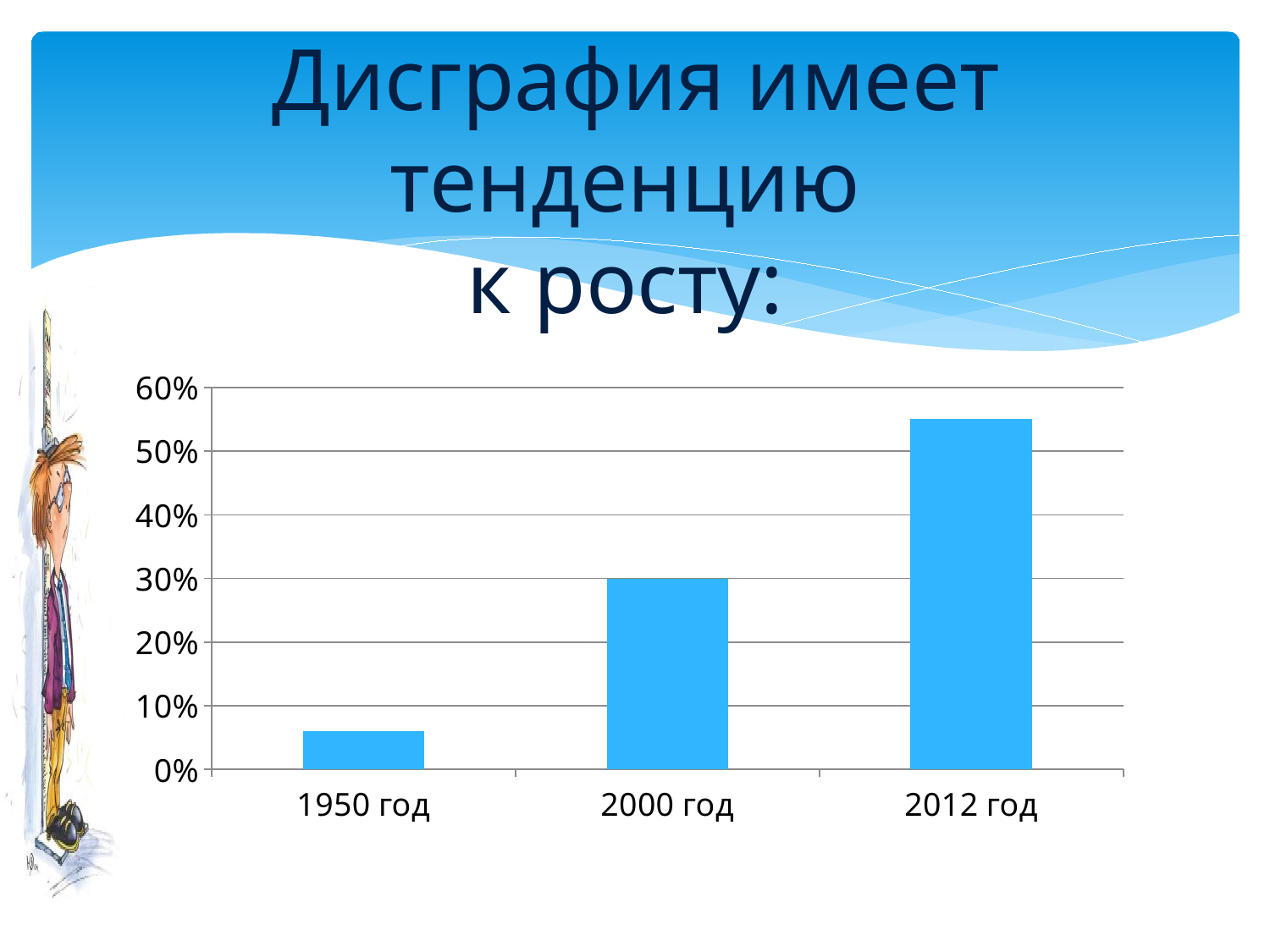
Do the values rise or fall from 1950 год to 2012 год? rise Is the value for 1950 год greater or less than 10%? less What kind of chart is shown on the slide? bar chart What colour are the bars in the chart? blue Which category has the highest value? 2012 год What is the value for 2000 год? 30% Which is larger, the value for 2000 год or the value for 2012 год? 2012 год Is the value for 2012 год greater or less than 50%? greater Is the value for 2012 год greater or less than 60%? less What is the highest value shown on the vertical axis? 60% How many categories are shown on the x axis of the chart? 3 Which category has the lowest value? 1950 год